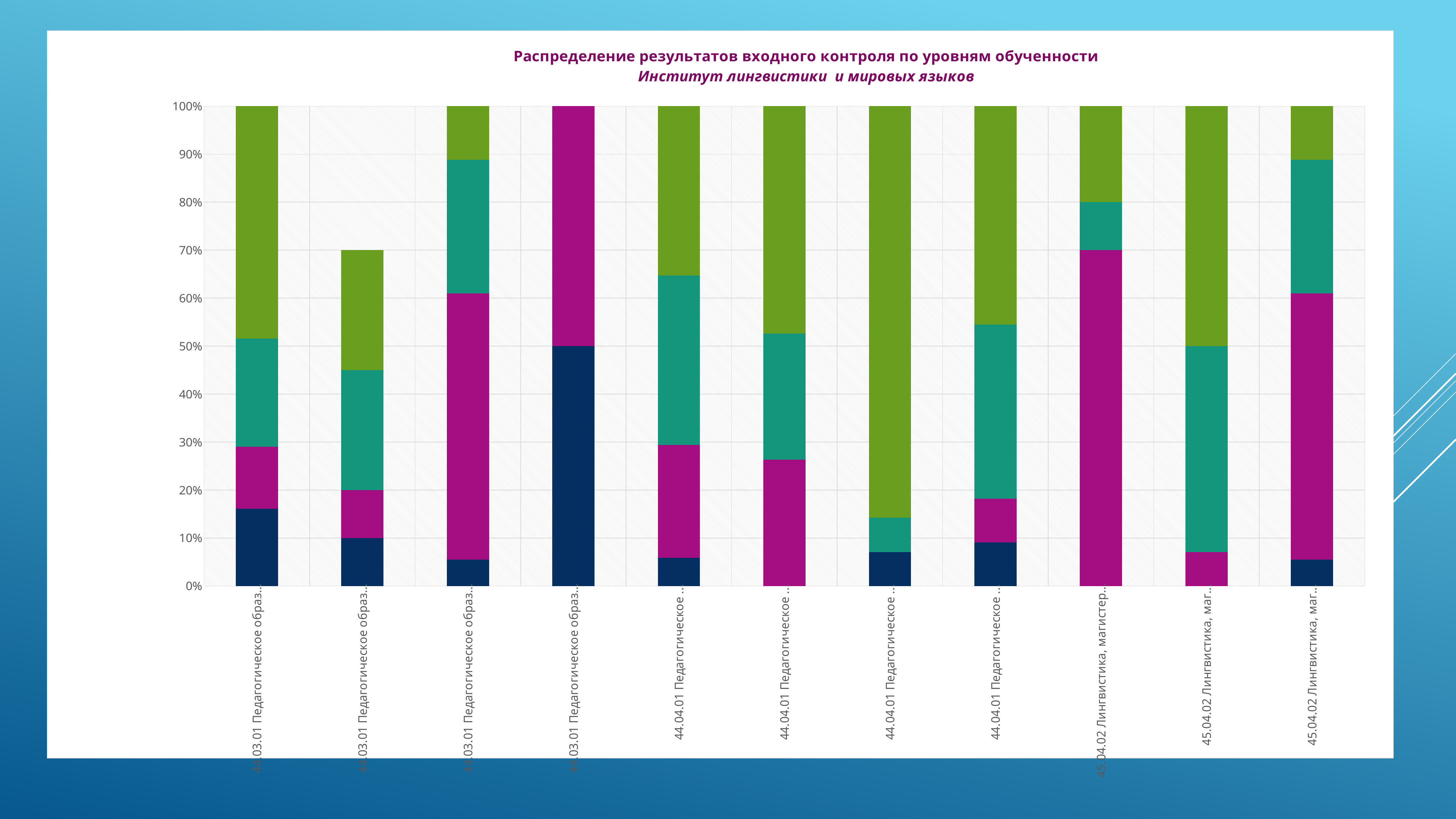
At what value does the magenta segment of the ninth bar from the left end? 70% Is the top of the dark blue segment in the first bar from the left greater or less than 20%? less What kind of chart is shown on the slide? Stacked bar chart What is the main title of the chart? Распределение результатов входного контроля по уровням обученности What institute is named in the chart's subtitle? Институт лингвистики и мировых языков What is the total height of the second bar from the left? 70% How many bars are plotted in the chart? 11 At what value does the teal segment of the tenth bar from the left end? 50% At what value does the dark blue segment of the fourth bar from the left end? 50% Is the top of the magenta segment in the third bar from the left greater or less than 50%? greater Which bar is the only one that does not reach 100%? The second bar from the left Is the bottom of the green segment in the seventh bar from the left greater or less than 20%? less